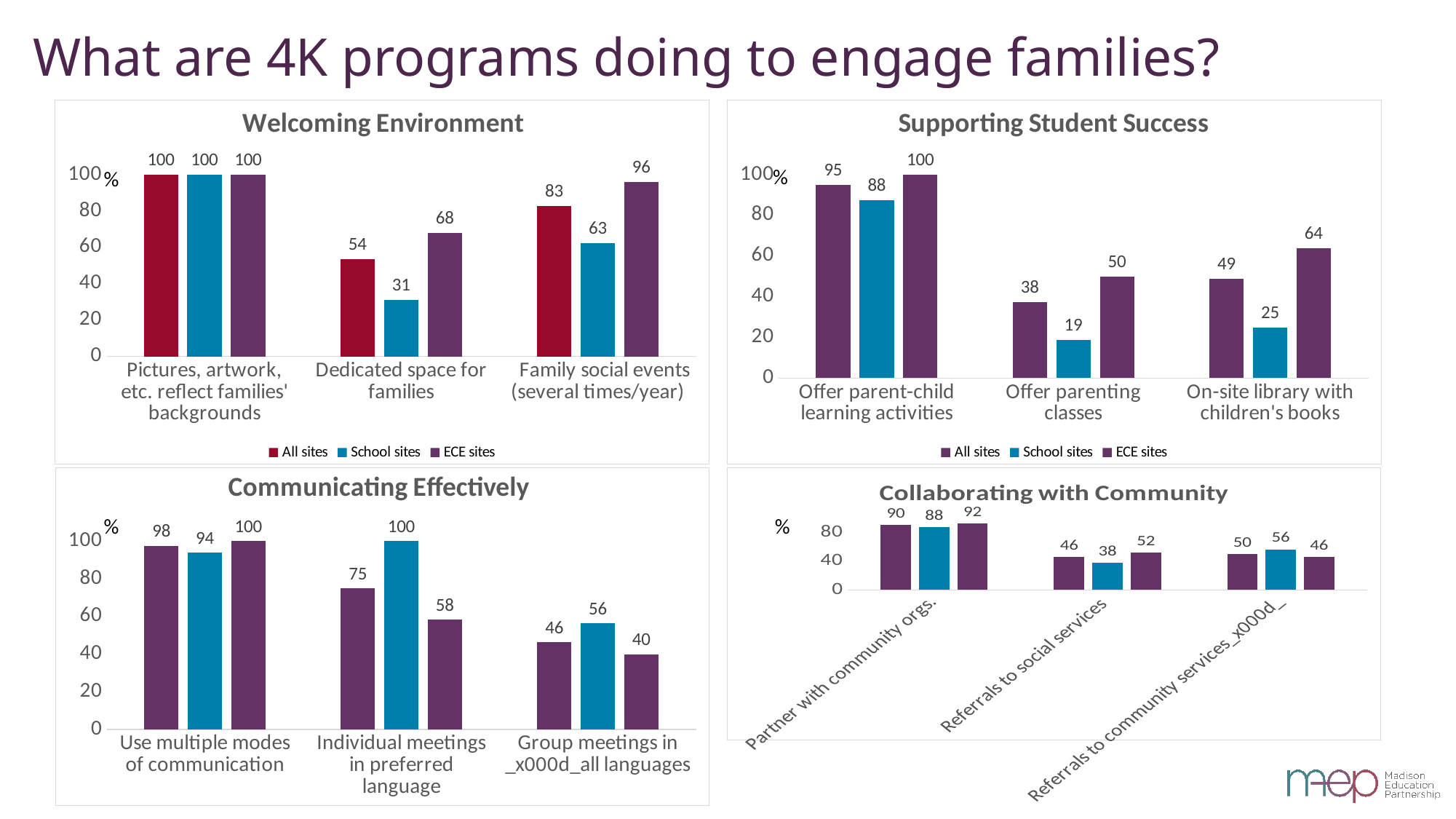
In the Welcoming Environment chart, what is the value for School sites for Dedicated space for families? 31 In the Welcoming Environment chart, what is the difference between the ECE sites and All sites values for Family social events (several times/year)? 13 What kind of chart is the Welcoming Environment chart? Bar chart In the Supporting Student Success chart, is the All sites value for On-site library with children's books greater or less than 40? greater In the Welcoming Environment chart, how many series does the legend list? 3 In the Supporting Student Success chart, what is the value for School sites for Offer parenting classes? 19 In the Collaborating with Community chart, what is the lowest value shown for Referrals to social services? 38 In the Communicating Effectively chart, how many categories are shown on the x axis? 3 In the Supporting Student Success chart, which category has the lowest ECE sites value? Offer parenting classes In the Communicating Effectively chart, which is larger for Group meetings in all languages: the School sites value or the ECE sites value? School sites In the Collaborating with Community chart, what is the highest value shown for Partner with community orgs.? 92 In the Communicating Effectively chart, what is the value for School sites for Individual meetings in preferred language? 100